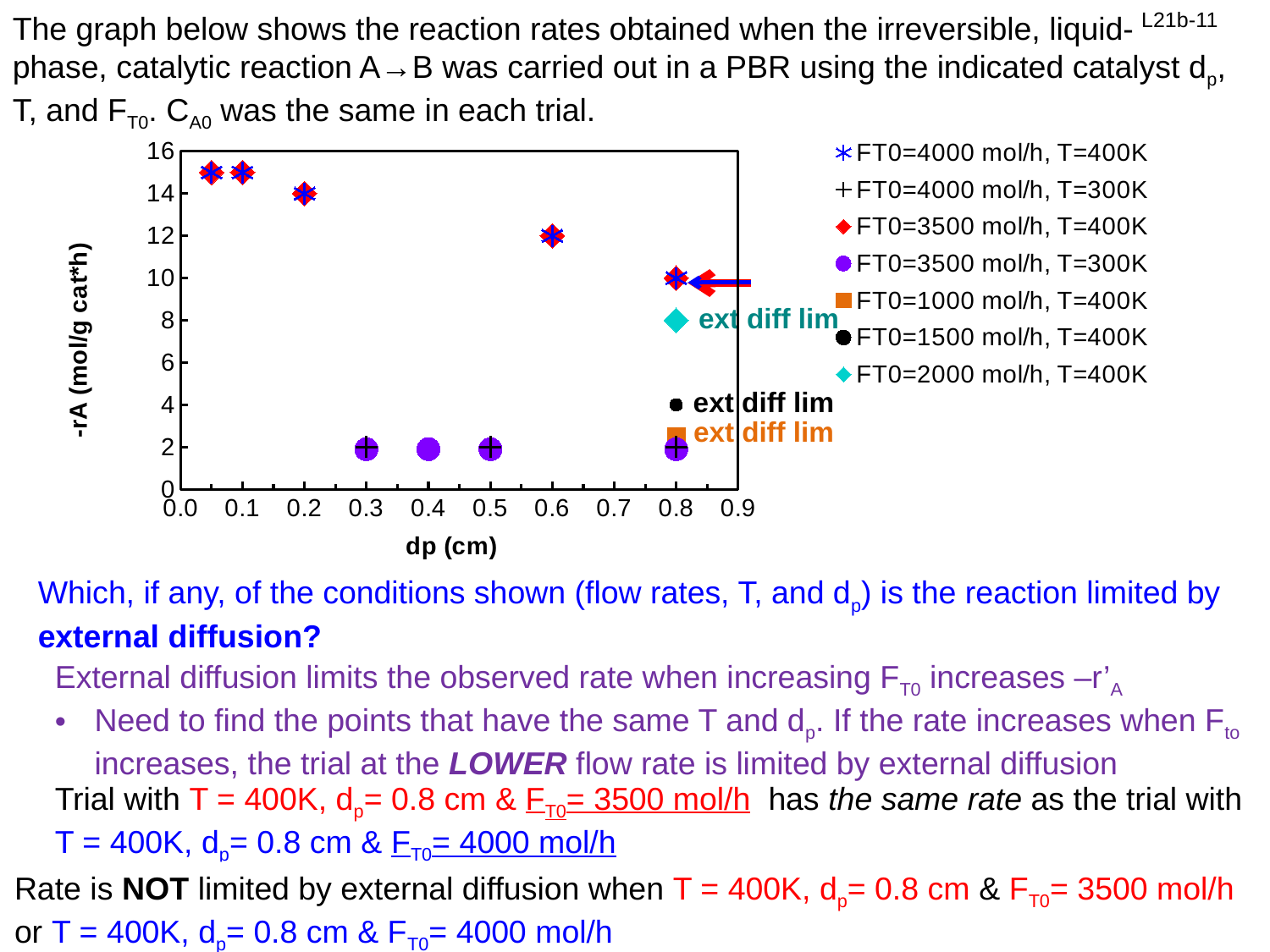
What kind of chart is shown on the slide? scatter chart How many series does the chart legend list? 7 Is the value of -rA for the FT0=3500 mol/h, T=300K series at dp = 0.4 cm greater or less than 4? less What is the value of -rA for the FT0=4000 mol/h, T=400K series at dp = 0.8 cm? 10 What is the value of -rA for the FT0=2000 mol/h, T=400K series at dp = 0.8 cm? 8 At dp = 0.8 cm, which has the larger -rA: the FT0=2000 mol/h, T=400K series or the FT0=1500 mol/h, T=400K series? FT0=2000 mol/h, T=400K What is the value of -rA for the FT0=1500 mol/h, T=400K series at dp = 0.8 cm? 4 What is the label of the y axis of the chart? -rA (mol/g cat*h) What is the label of the x axis of the chart? dp (cm) For the T=400K series with FT0=4000 mol/h, does -rA rise or fall as dp increases? fall Is the value of -rA for the FT0=1000 mol/h, T=400K series at dp = 0.8 cm greater or less than 4? less Is the value of -rA for the FT0=4000 mol/h, T=400K series at dp = 0.1 cm greater or less than 14? greater